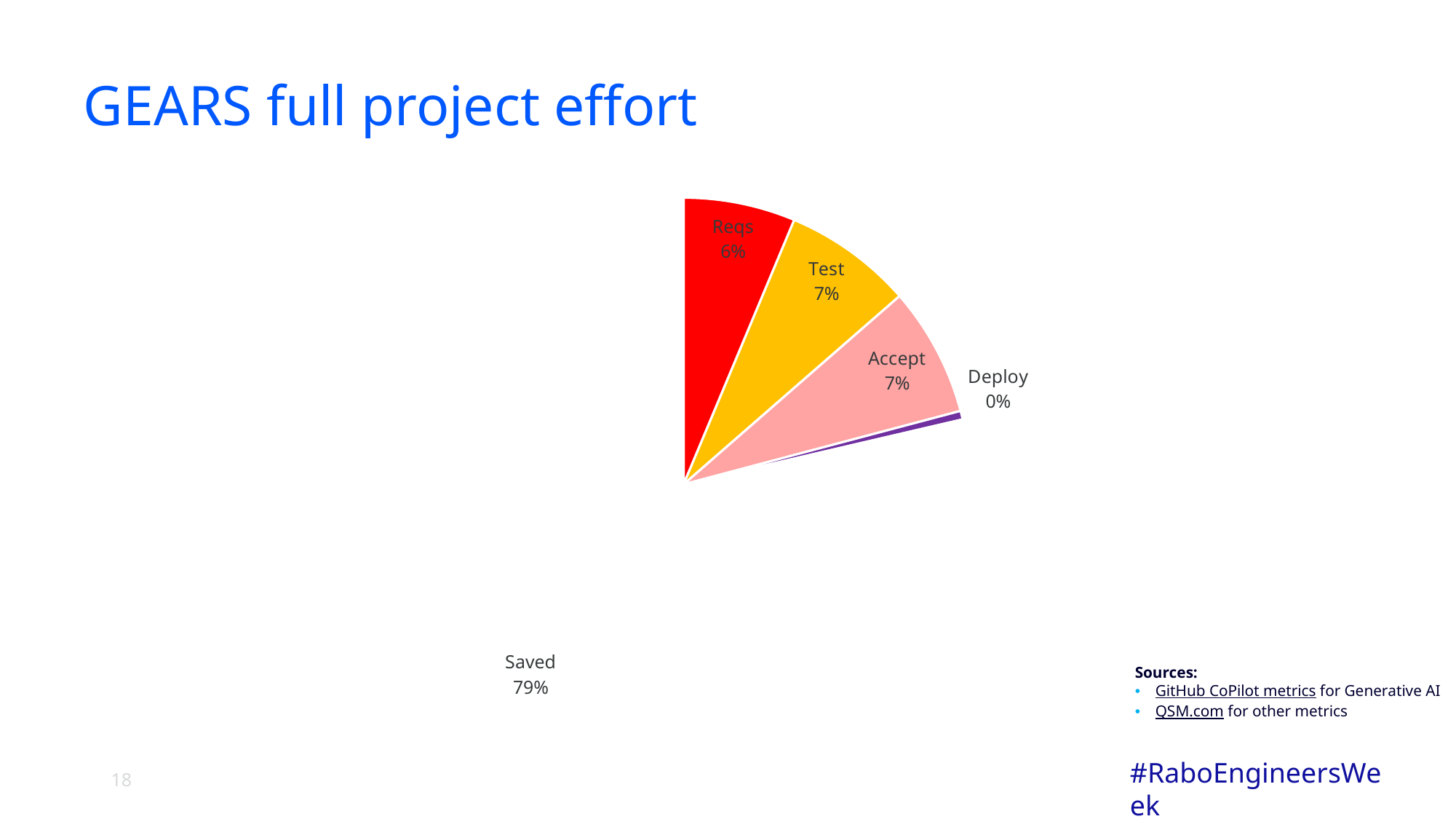
What is the difference in percentage points between Saved and Reqs? 73 What share of the pie is labelled Saved? 79% Which category has the smallest share of the pie? Deploy Which category has the largest share of the pie? Saved How many categories are labelled on the chart? 5 What percentage is shown for the Accept slice? 7% What percentage is shown for Deploy? 0% Which has a larger share, Test or Reqs? Test What kind of chart is shown on the slide? Pie chart What percentage of the pie is labelled Reqs? 6% What percentage is shown for the Test slice? 7% What is the title of the slide containing the chart? GEARS full project effort